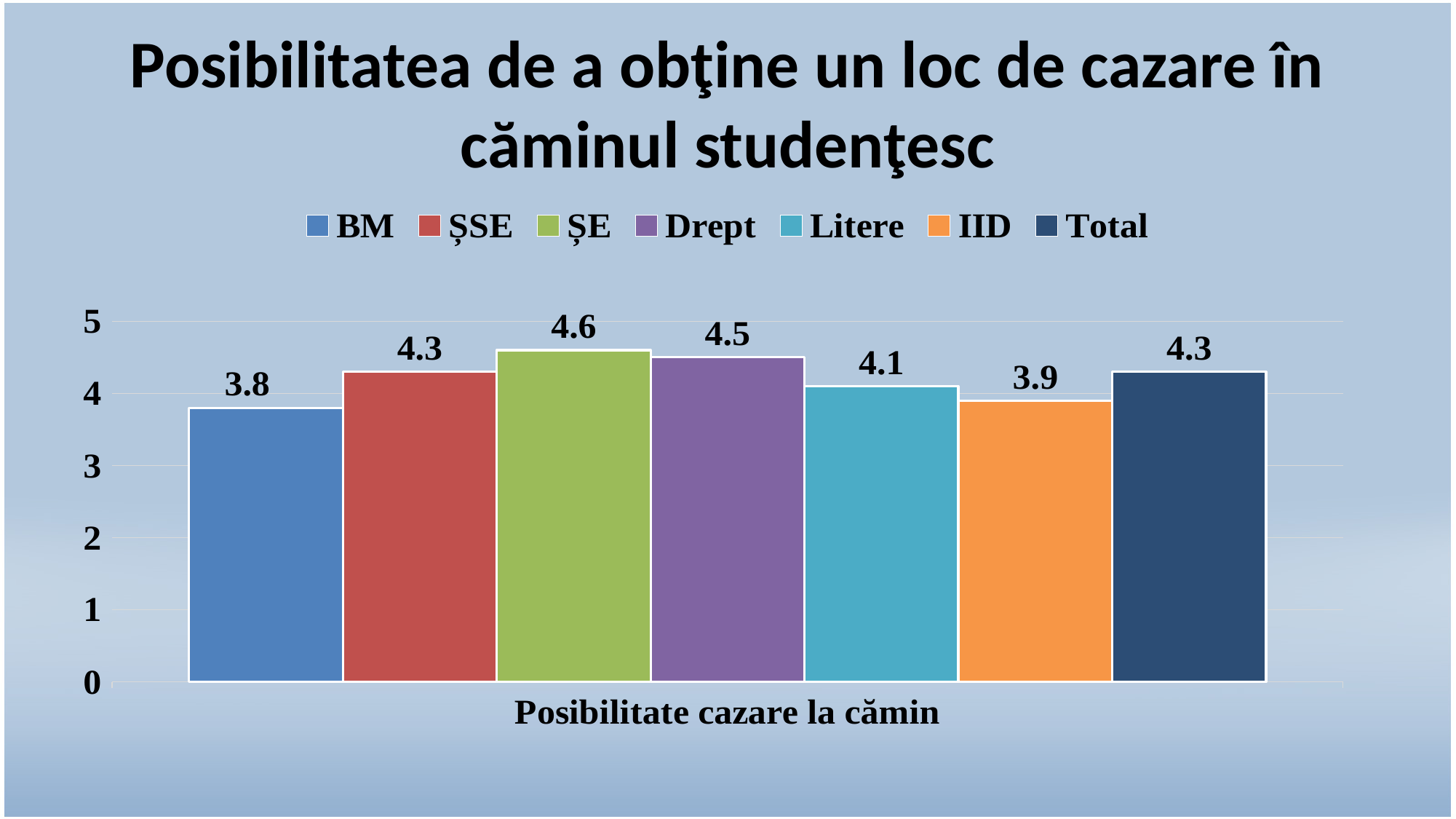
How many series does the legend list? 7 Which series has the highest value? ȘE What is the value for Litere? 4.1 What is the label on the x axis of the chart? Posibilitate cazare la cămin What kind of chart is shown on the slide? bar chart Which is larger, the value for Drept or the value for IID? Drept What is the difference between the values for ȘE and BM? 0.8 Which series has the lowest value? BM Is the value for IID greater or less than 3? greater What is the value for Total? 4.3 What is the value for Drept? 4.5 What is the value for BM? 3.8